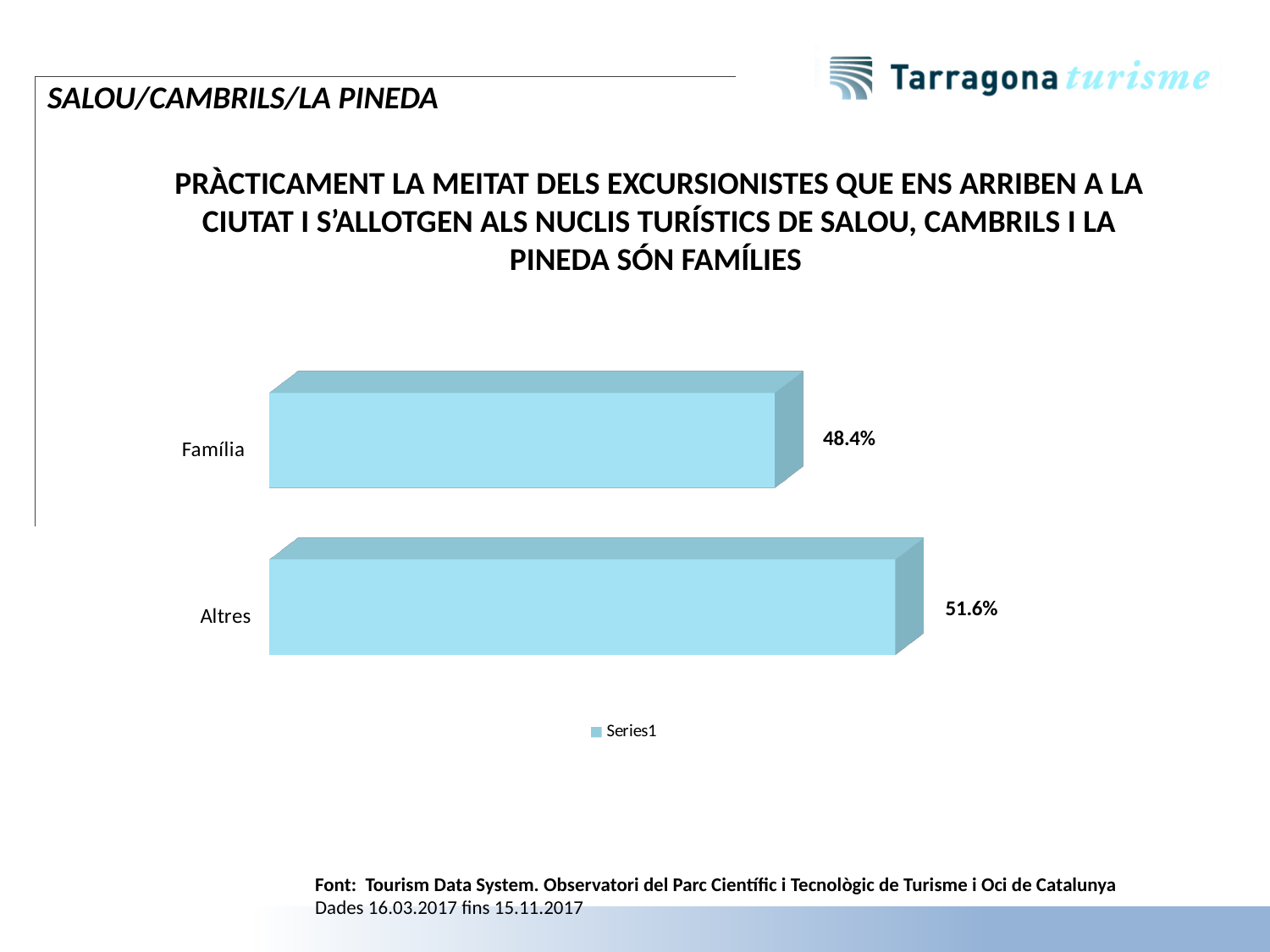
What is the total of the two values shown in the chart? 100% What is the value for Família? 48.4% What kind of chart is shown on the slide? Bar chart Which is larger, the value for Família or the value for Altres? Altres What colour are the bars in the chart? Light blue How many series does the legend list? 1 What is the name of the series listed in the legend? Series1 What is the difference between the values for Altres and Família? 3.2% What is the value for Altres? 51.6% Which category has the lowest value? Família Which category has the highest value? Altres How many categories are shown in the chart? 2